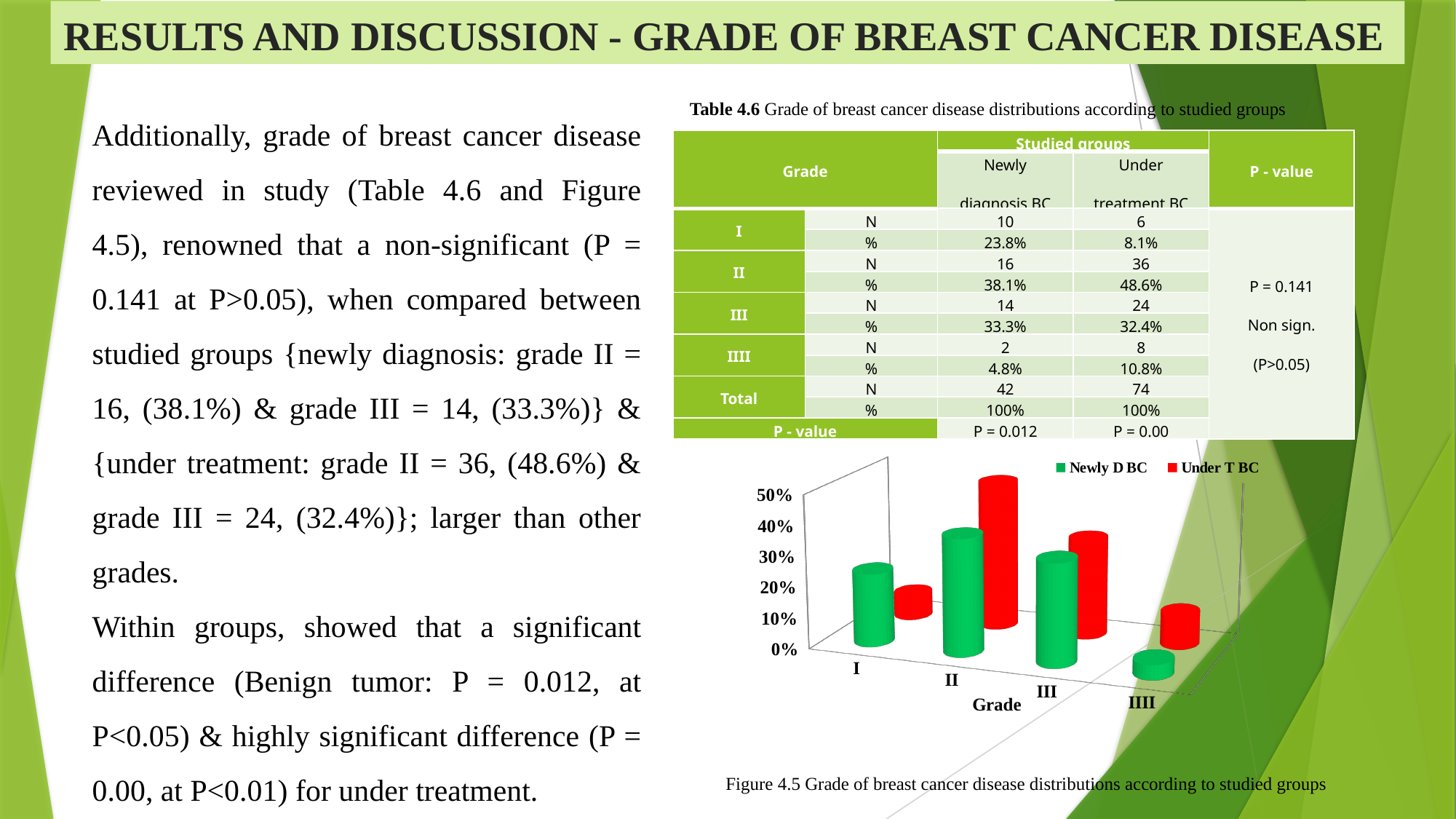
In the chart, which grade has the highest value for Newly D BC? II In the chart, is the value for Newly D BC at grade IIII greater or less than 10%? less In the chart, which grade has the lowest value for Under T BC? I In the chart, which grade has the lowest value for Newly D BC? IIII In the chart, which grade has the highest value for Under T BC? II What is the title of the x axis of the chart? Grade In the chart, is the value for Under T BC at grade II greater or less than 40%? greater What kind of chart is Figure 4.5? bar chart In the chart, at grade I, which series has the larger value, Newly D BC or Under T BC? Newly D BC How many grade categories are shown on the x axis of the chart? 4 How many series does the legend of the chart list? 2 In the chart, is the value for Under T BC at grade I greater or less than 20%? less